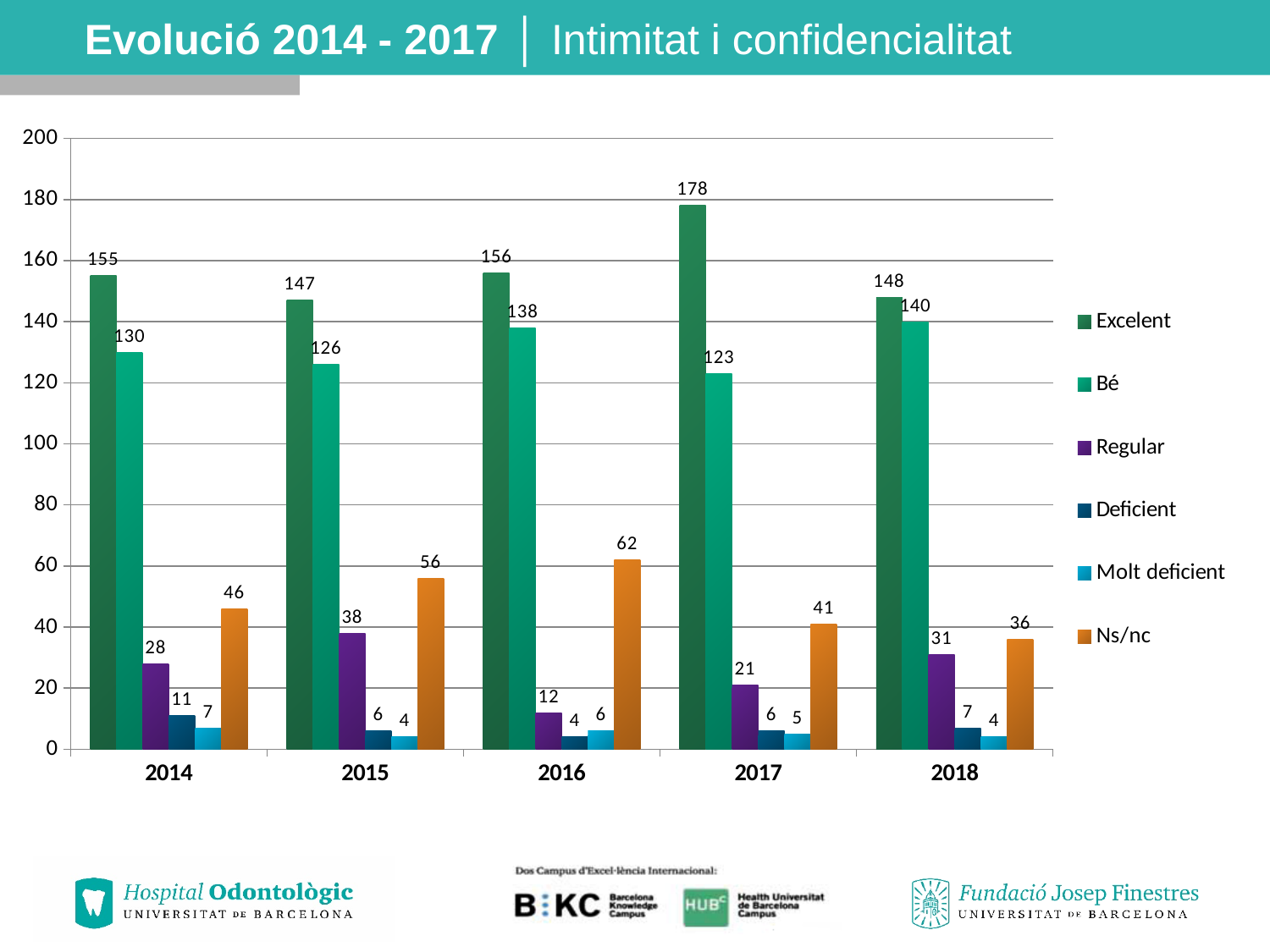
How many series does the legend list? 6 Which is larger in 2018, Regular or Ns/nc? Ns/nc Is the value for Bé in 2016 greater or less than 120? greater How many years are shown on the x axis? 5 What is the difference between the Excelent and Bé values in 2017? 55 What is the value for Ns/nc in 2016? 62 What is the value for Regular in 2015? 38 What is the title of the slide? Evolució 2014 - 2017 | Intimitat i confidencialitat What is the value for Excelent in 2017? 178 In which year is the Excelent value highest? 2017 What kind of chart is shown on the slide? bar chart In which year is the Bé value lowest? 2017